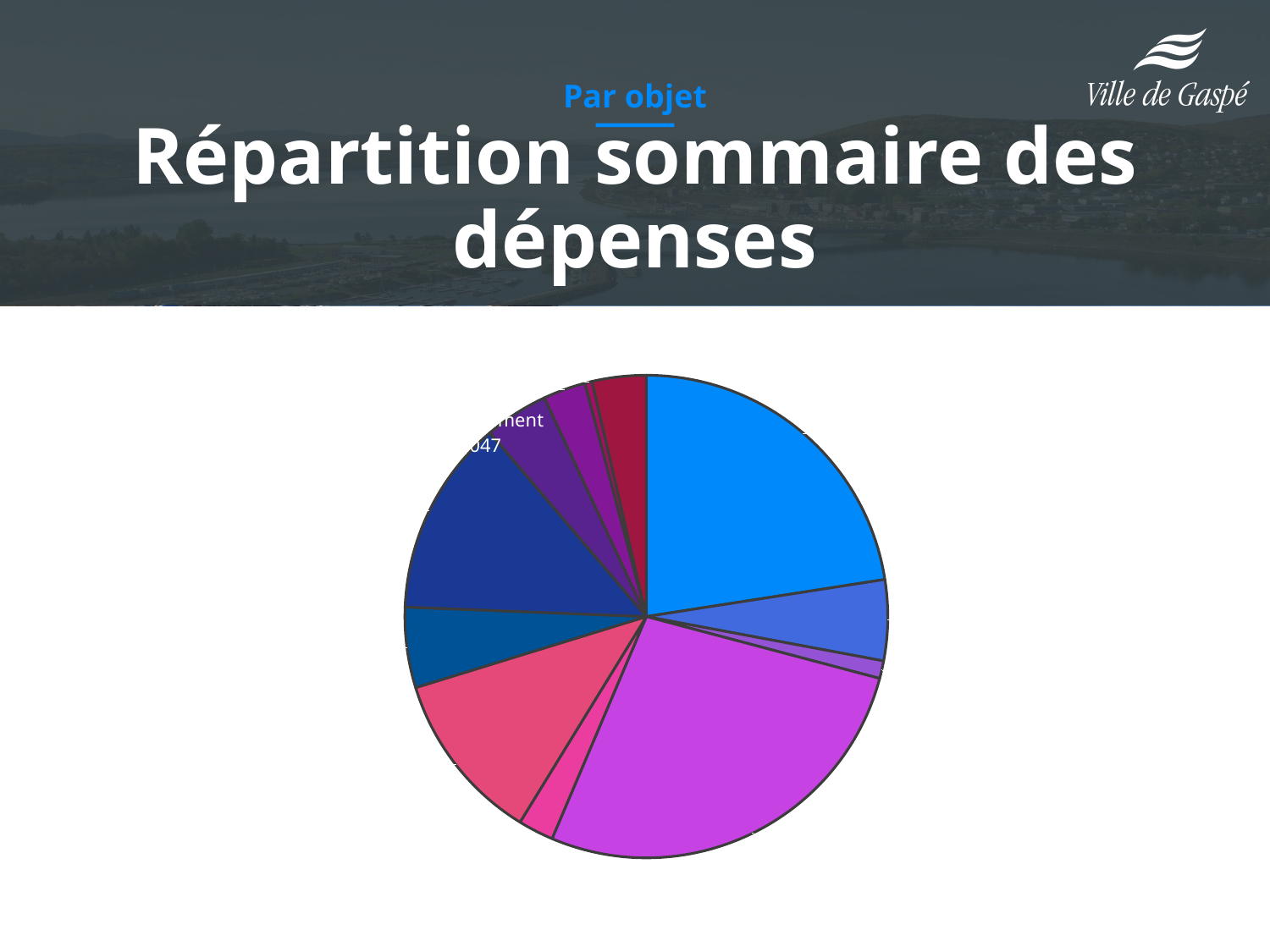
What subtitle appears above the chart title? Par objet What kind of chart is shown on the slide? pie chart Does the chart include a legend? No Which slice is larger: the bright blue slice at the top right or the magenta slice at the bottom? the magenta slice at the bottom What is the title of the chart on the slide? Répartition sommaire des dépenses